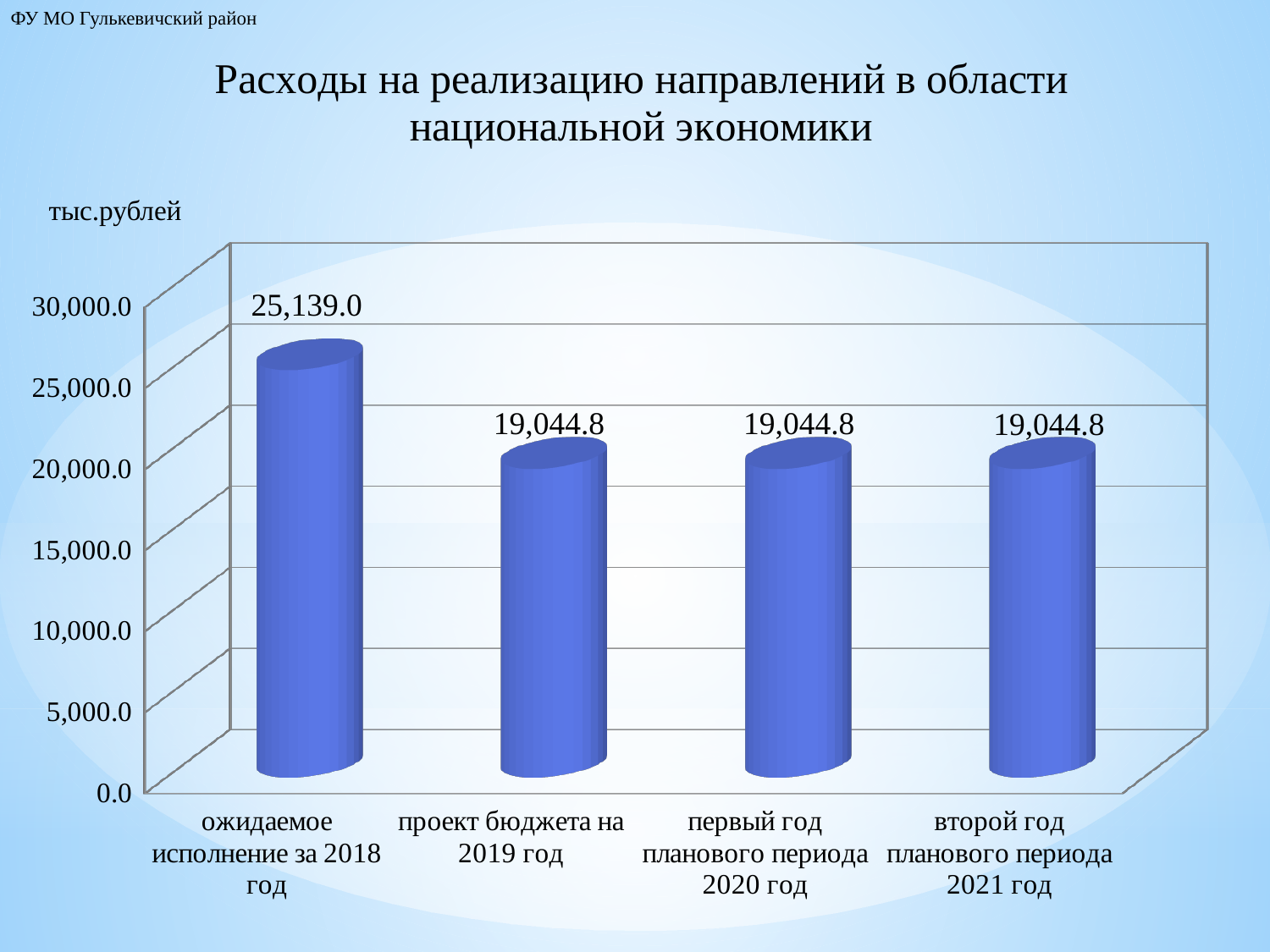
What is the value for 'ожидаемое исполнение за 2018 год'? 25,139.0 What is the value for 'проект бюджета на 2019 год'? 19,044.8 How many categories are shown on the x axis? 4 What is the difference between the value for 2018 (ожидаемое исполнение) and the value for 2019 (проект бюджета)? 6,094.2 Is the value for 'ожидаемое исполнение за 2018 год' greater or less than 25,000.0? greater What is the value for 'второй год планового периода 2021 год'? 19,044.8 What kind of chart is shown on the slide? bar chart What unit is indicated above the chart's vertical axis? тыс.рублей Is the value for 'проект бюджета на 2019 год' greater or less than 20,000.0? less Do the values rise or fall from the 2018 category to the 2019 category? fall Which is larger: the value for 'ожидаемое исполнение за 2018 год' or the value for 'первый год планового периода 2020 год'? ожидаемое исполнение за 2018 год Which category has the highest value? ожидаемое исполнение за 2018 год